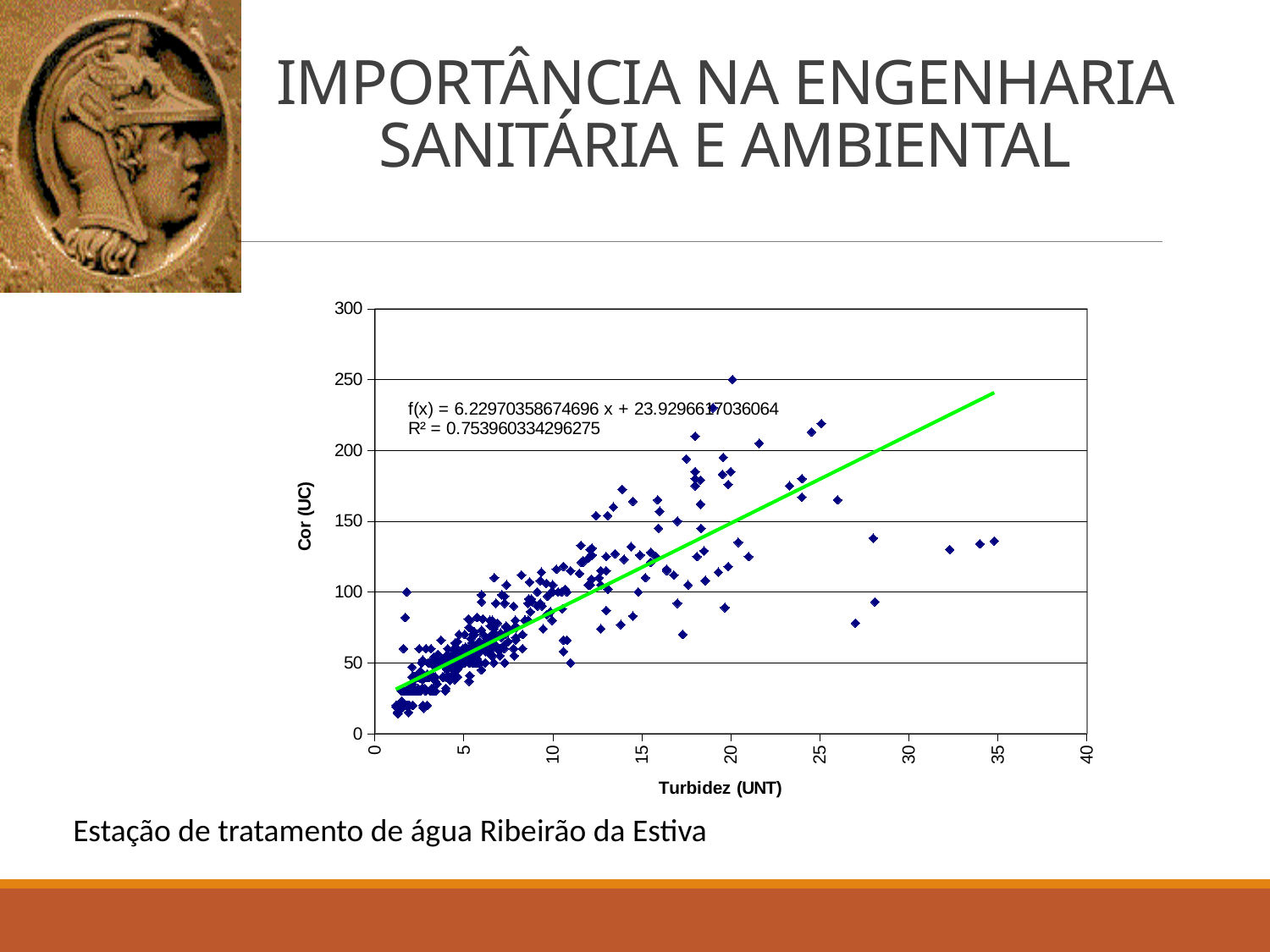
What is the title of the x axis of the chart? Turbidez (UNT) Is the value of the fitted trend line at a turbidity of 5 UNT greater or less than 100? less Is the highest plotted Cor (UC) value greater or less than 200? greater What is the slope (coefficient of x) in the fitted line equation printed on the chart? 6.22970358674696 What is the highest tick value shown on the x axis (Turbidez)? 40 Are the plotted points at a turbidity of around 34 UNT greater or less than 150 UC? less What kind of chart is shown on the slide? Scatter chart What is the highest tick value shown on the y axis (Cor)? 300 What is the title of the y axis of the chart? Cor (UC) As turbidity (Turbidez) increases along the x axis, do the colour (Cor) values generally rise or fall? Rise What R² value is printed on the chart for the fitted line? 0.753960334296275